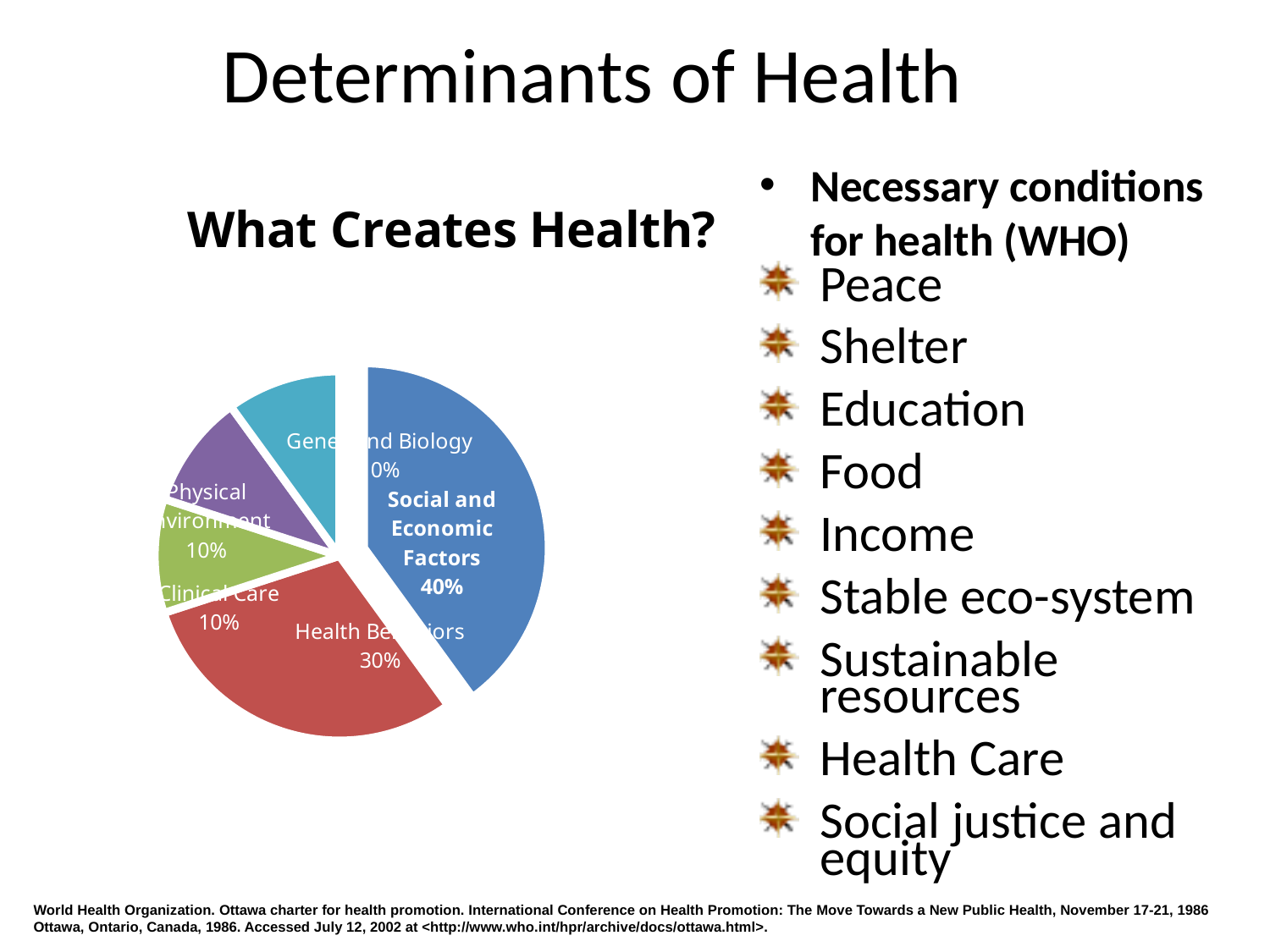
What is the difference between the Health Behaviors share and the Clinical Care share? 20% How many slices does the pie chart have? 5 What is the difference between the Social and Economic Factors share and the Health Behaviors share? 10% Which slice of the pie is the largest? Social and Economic Factors What share of the pie is Health Behaviors? 30% What kind of chart is shown on the slide? pie chart Which is larger, Health Behaviors or Clinical Care? Health Behaviors What is the title of the chart on the slide? What Creates Health? Which is larger, Social and Economic Factors or Health Behaviors? Social and Economic Factors What value is shown for Physical Environment? 10% What value is shown for Clinical Care? 10% What share of the pie is Social and Economic Factors? 40%